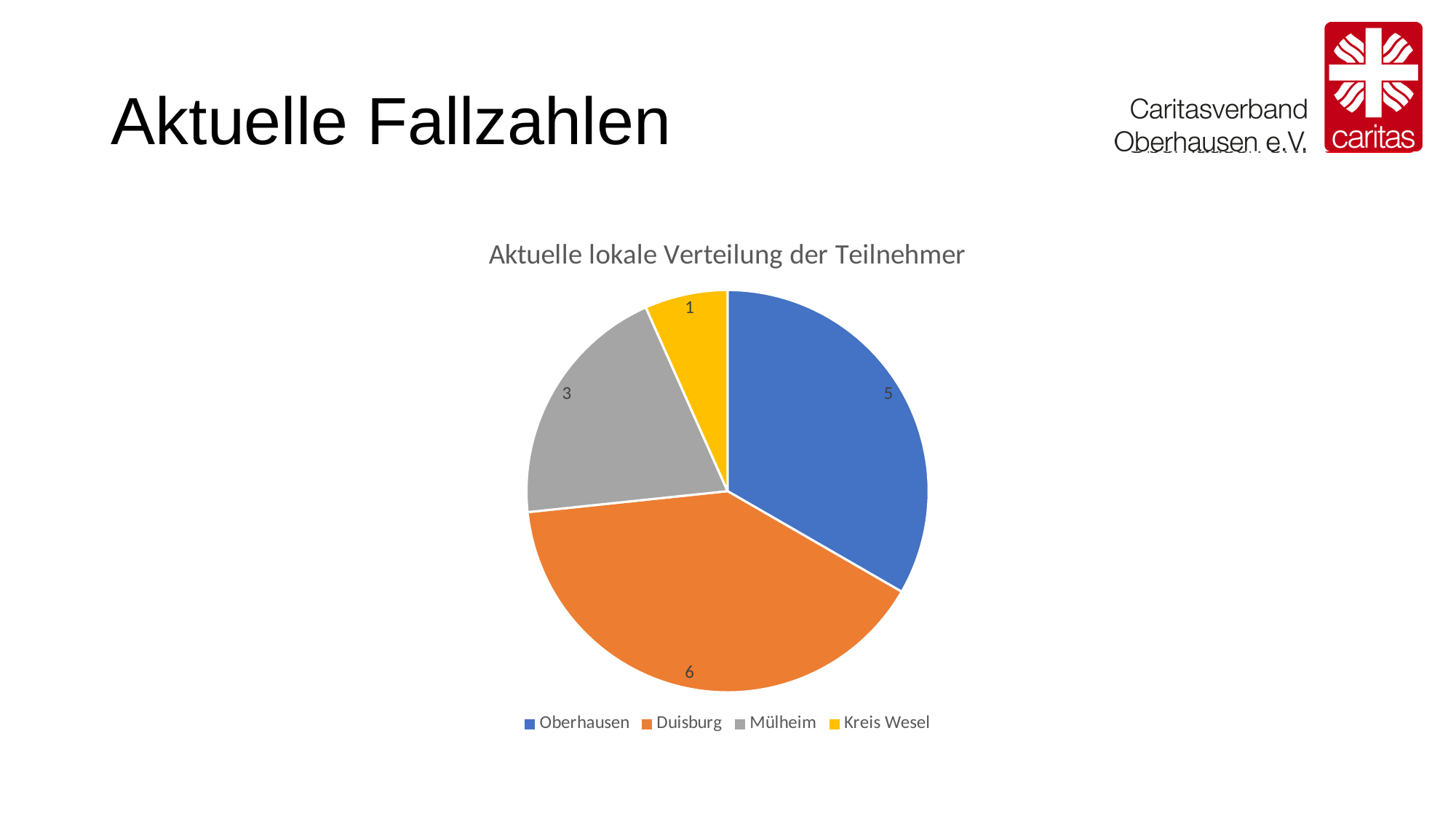
Which category has the largest slice? Duisburg What is the difference between the values for Duisburg and Mülheim? 3 What is the value for Mülheim? 3 What is the title of the chart? Aktuelle lokale Verteilung der Teilnehmer What share of the pie does Duisburg represent? 40% What is the value for Duisburg? 6 What type of chart is shown on the slide? pie chart Which category has the smallest slice? Kreis Wesel How many categories does the legend list? 4 What is the value for Oberhausen? 5 What is the value for Kreis Wesel? 1 Which is larger, the value for Oberhausen or the value for Mülheim? Oberhausen